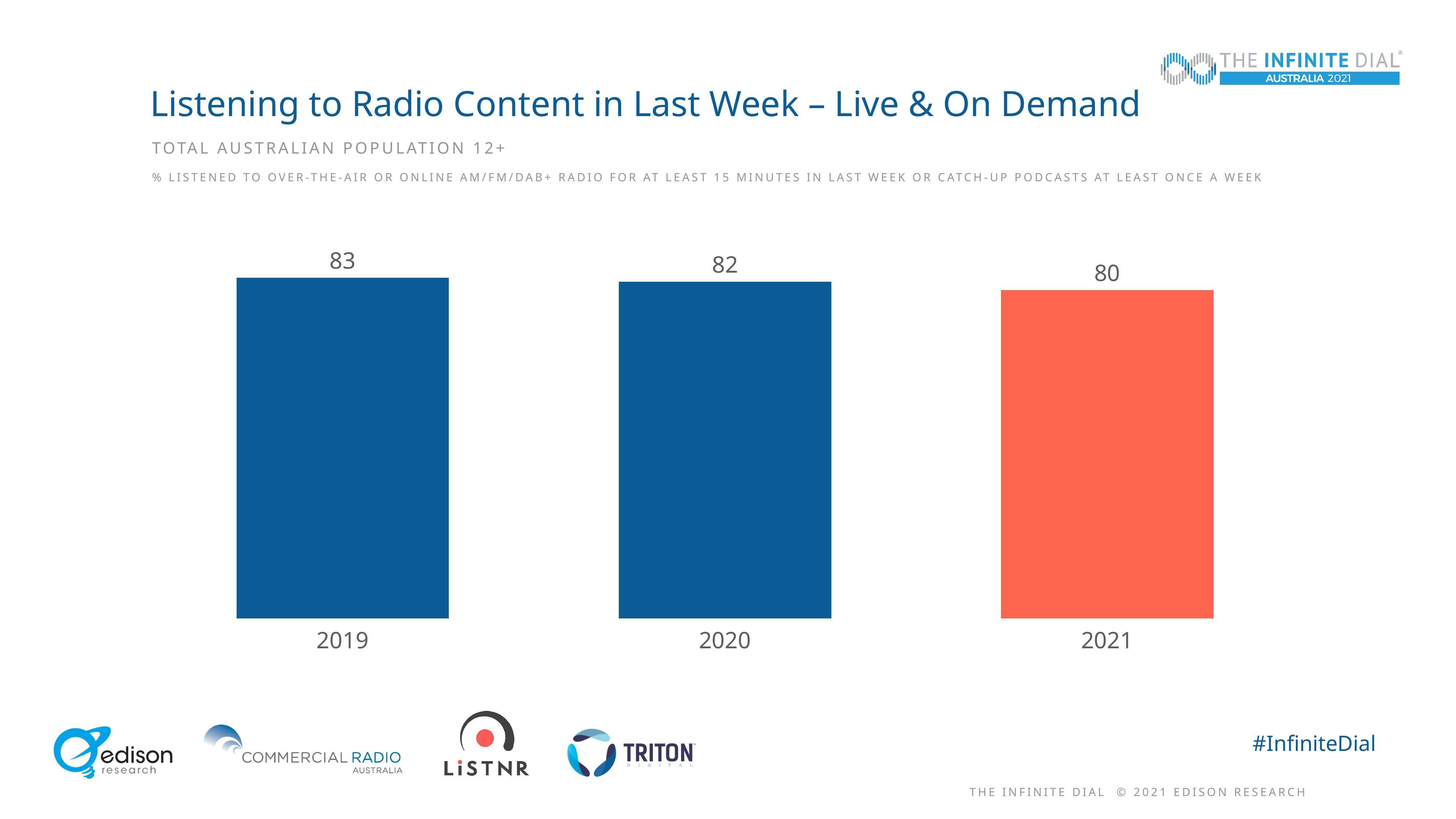
Which is larger, the value for 2019 or the value for 2021? 2019 What is the value for 2019? 83 What is the value for 2021? 80 What is the value for 2020? 82 How many years are shown in the chart? 3 Which year has the highest value? 2019 Which year has the lowest value? 2021 What is the difference between the values for 2019 and 2021? 3 Do the values rise or fall from 2019 to 2021? Fall What is the difference between the values for 2020 and 2021? 2 What kind of chart is shown on the slide? Bar chart Which year's bar is coloured differently from the others? 2021